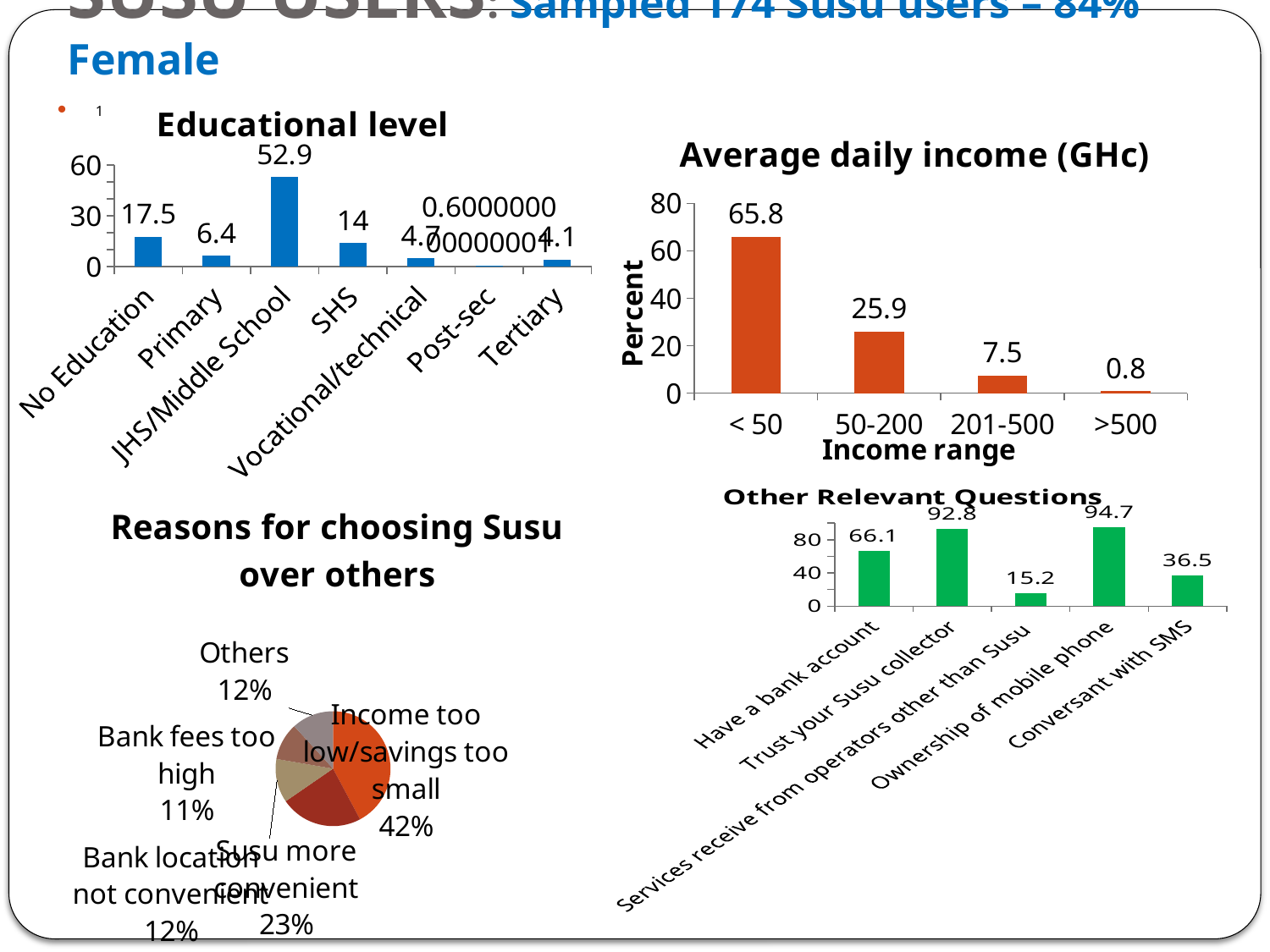
In the 'Reasons for choosing Susu over others' pie chart, what share is 'Susu more convenient'? 23% In the 'Educational level' chart, what is the value for JHS/Middle School? 52.9 In the 'Average daily income (GHc)' chart, how many income ranges are shown? 4 In the 'Average daily income (GHc)' chart, what is the value for the 50-200 income range? 25.9 In the 'Other Relevant Questions' chart, which is larger: 'Have a bank account' or 'Conversant with SMS'? Have a bank account In the 'Other Relevant Questions' chart, which category has the highest value? Ownership of mobile phone In the 'Educational level' chart, which category has the highest value? JHS/Middle School In the 'Average daily income (GHc)' chart, which income range has the lowest value? >500 In the 'Other Relevant Questions' chart, what is the value for 'Trust your Susu collector'? 92.8 In the 'Educational level' chart, what is the difference between the values for No Education and Primary? 11.1 In the 'Average daily income (GHc)' chart, do the values rise or fall as you move from left to right along the x axis? fall What kind of chart is 'Reasons for choosing Susu over others'? pie chart